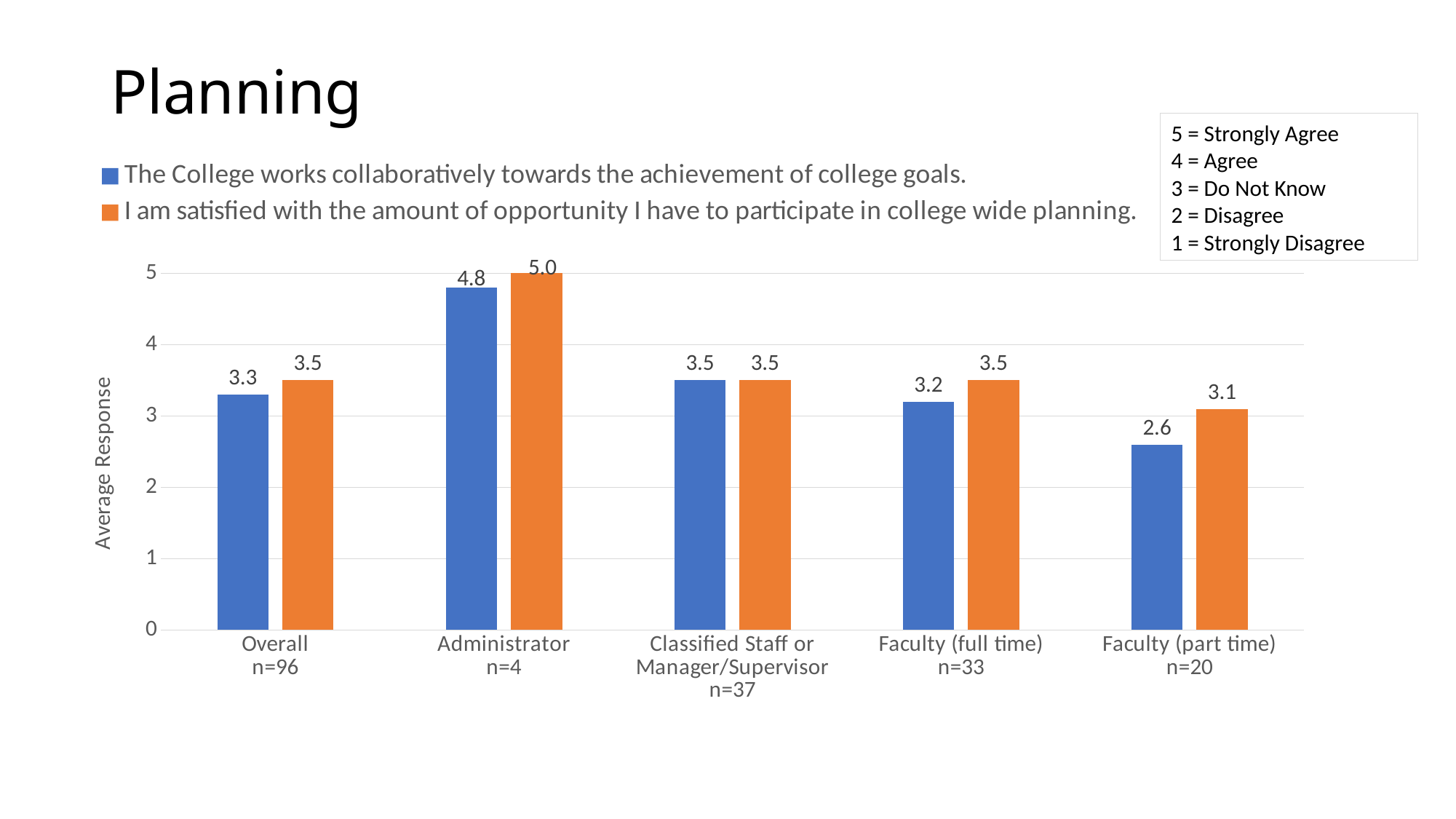
Which group has the lowest average response for "The College works collaboratively towards the achievement of college goals"? Faculty (part time) What is the average response for Faculty (part time) on "I am satisfied with the amount of opportunity I have to participate in college wide planning"? 3.1 What is the Overall average response for "The College works collaboratively towards the achievement of college goals"? 3.3 What is the average response for Administrator on "The College works collaboratively towards the achievement of college goals"? 4.8 How many series does the legend list? 2 What kind of chart is shown on the slide? Bar chart Is the Administrator average response for "The College works collaboratively towards the achievement of college goals" greater or less than 4? greater What is the difference between the two average responses for Faculty (part time)? 0.5 How many respondent groups are shown on the x axis? 5 What is the label of the vertical axis? Average Response Which group has the highest average response for "I am satisfied with the amount of opportunity I have to participate in college wide planning"? Administrator For Faculty (full time), which statement has the higher average response? I am satisfied with the amount of opportunity I have to participate in college wide planning.